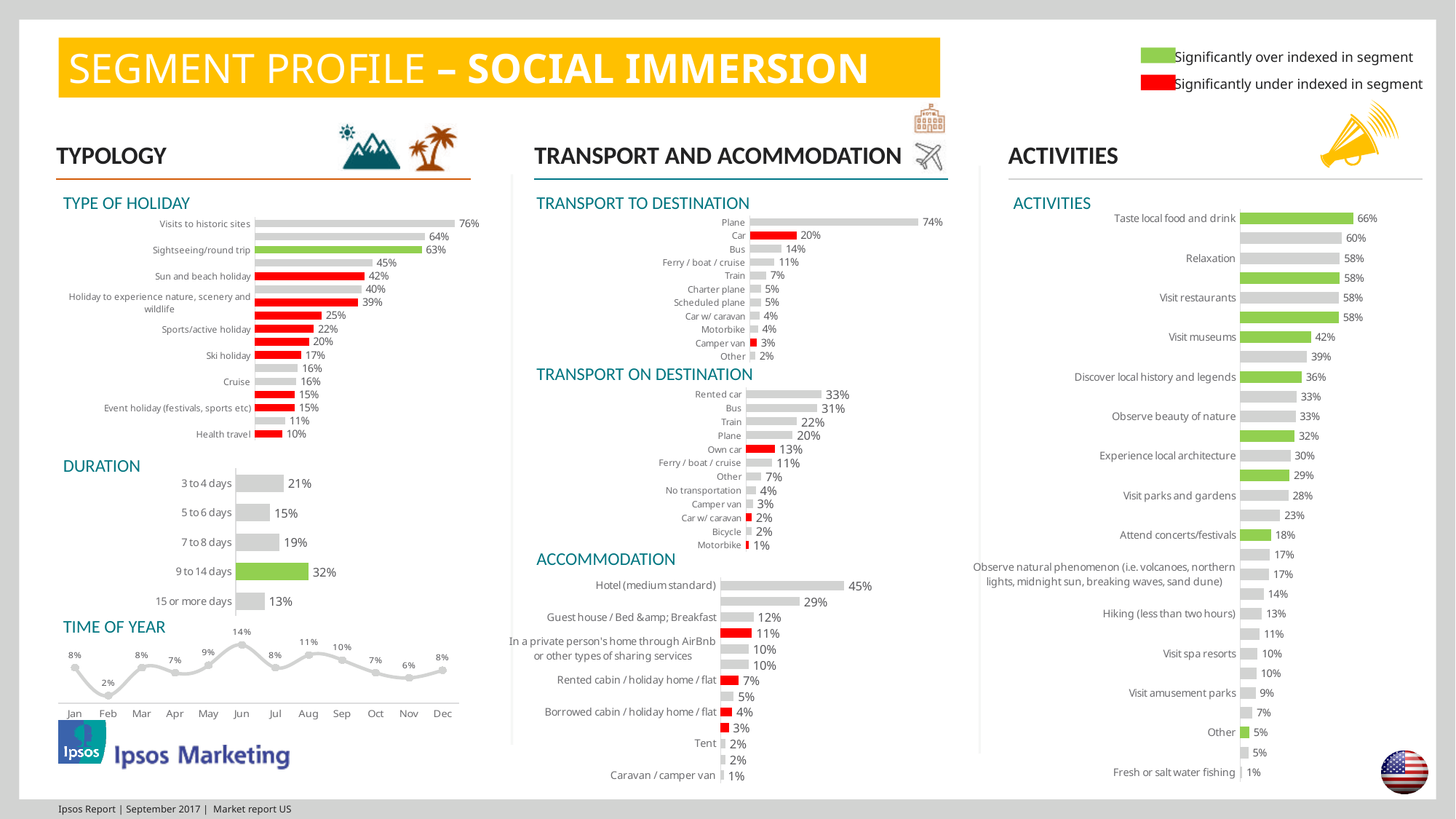
In the Accommodation chart, what is the value for Hotel (medium standard)? 45% In the Time of Year chart, which month has the highest value? Jun In the Activities chart, what percentage is shown for Taste local food and drink? 66% In the Duration chart, what is the value for 9 to 14 days? 32% How many categories are shown in the Duration chart? 5 In the Transport to Destination chart, which category has the lowest value? Other In the Transport on Destination chart, what is the difference between Rented car and Bus? 2 percentage points In the Transport to Destination chart, what percentage is shown for Plane? 74% In the Activities chart, which is larger: Visit museums or Visit spa resorts? Visit museums In the Time of Year chart, what is the value for Feb? 2% In the Duration chart, which category has the highest value? 9 to 14 days What type of chart is the Time of Year chart? Line chart